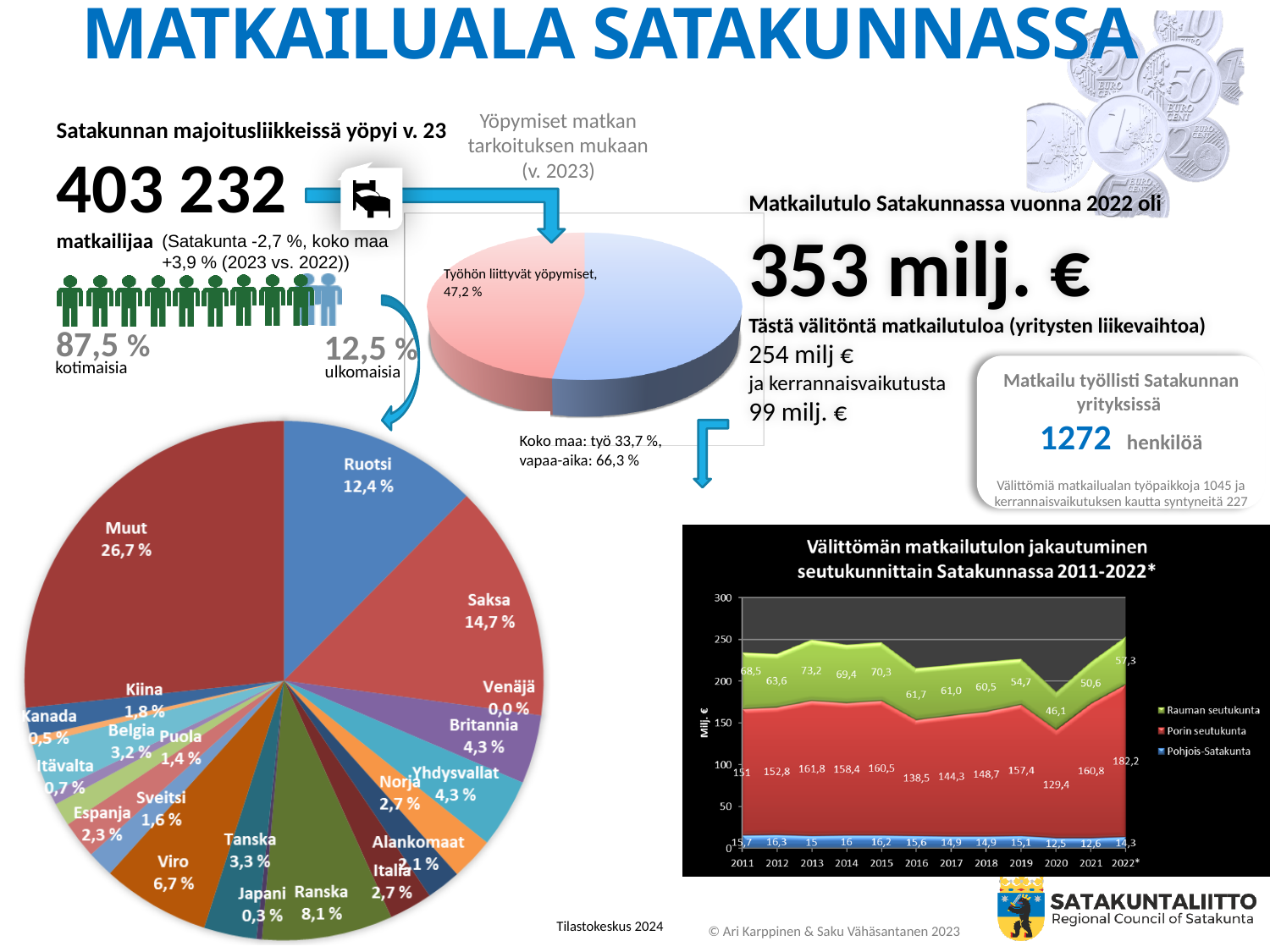
In the large pie chart of visitor countries, which has the larger share, Viro or Tanska? Viro In the chart 'Välittömän matkailutulon jakautuminen seutukunnittain Satakunnassa 2011-2022*', what is the value for Rauman seutukunta in 2020? 46,1 In the large pie chart of visitor countries, what share does Saksa have? 14,7 % In the chart 'Välittömän matkailutulon jakautuminen seutukunnittain Satakunnassa 2011-2022*', how many series does the legend list? 3 In the chart 'Välittömän matkailutulon jakautuminen seutukunnittain Satakunnassa 2011-2022*', what is the total of the three series in 2022*? 253,8 In the small pie chart 'Yöpymiset matkan tarkoituksen mukaan (v. 2023)', what share is labelled for Työhön liittyvät yöpymiset? 47,2 % In the large pie chart of visitor countries, how many percentage points larger is Saksa's share than Ruotsi's? 2,3 % In the chart 'Välittömän matkailutulon jakautuminen seutukunnittain Satakunnassa 2011-2022*', what is the value for Porin seutukunta in 2022*? 182,2 In the large pie chart of visitor countries, what share is shown for Venäjä? 0,0 % In the large pie chart of visitor countries, what share does Ruotsi have? 12,4 % In the chart 'Välittömän matkailutulon jakautuminen seutukunnittain Satakunnassa 2011-2022*', in which year is the Porin seutukunta value lowest? 2020 In the large pie chart of visitor countries, which slice is the largest? Muut